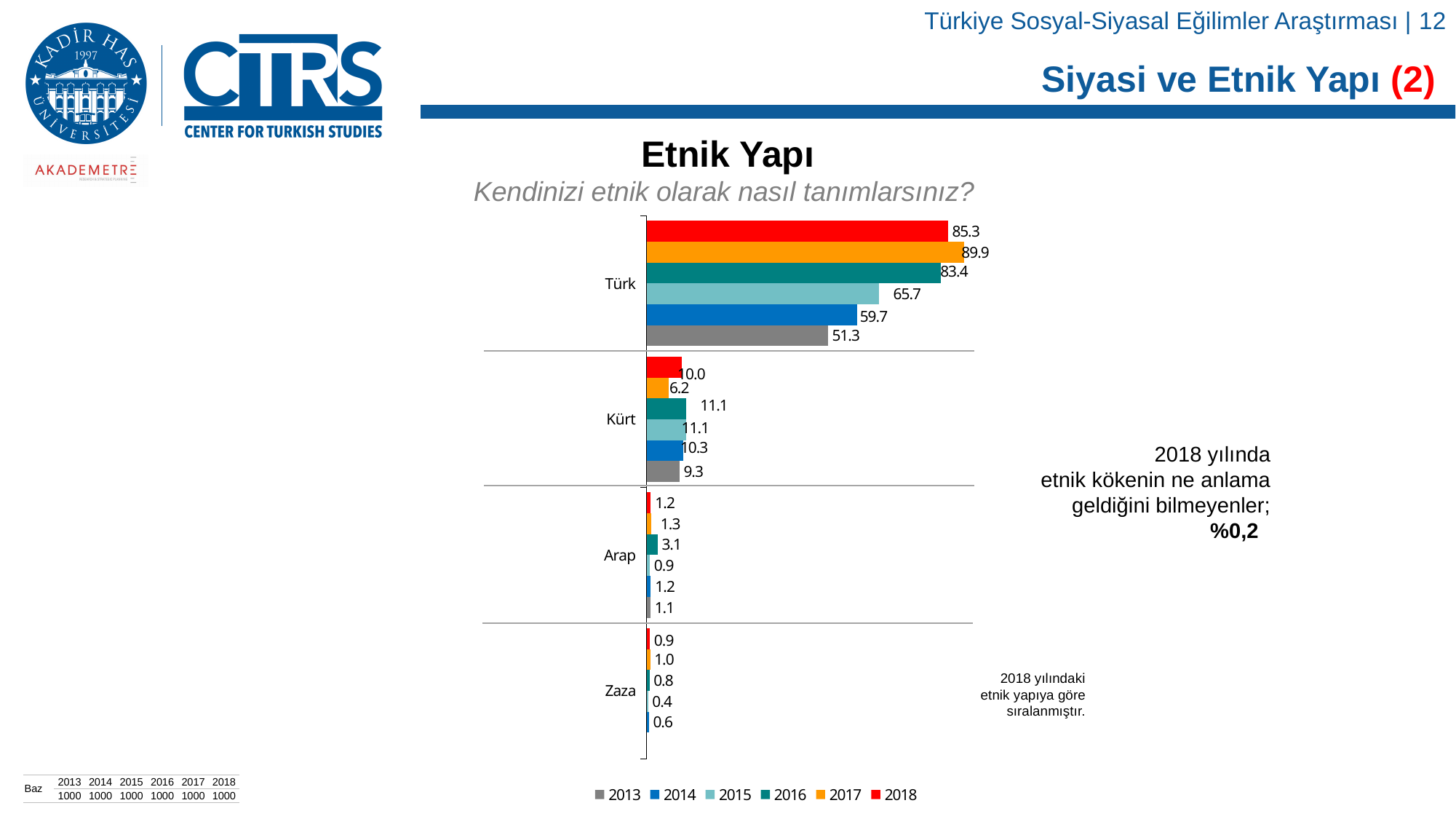
What is the value for Arap in 2016? 3.1 What is the difference between the Türk values for 2017 and 2013? 38.6 What is the value for Kürt in 2017? 6.2 What is the value for Zaza in 2015? 0.4 In which year was the value for Türk highest? 2017 How many ethnic categories are shown on the chart? 4 Which colour represents the 2018 series in the legend? red What kind of chart is shown on the slide? bar chart In which year was the value for Türk lowest? 2013 How many series does the legend list? 6 Which is larger for Kürt: the 2016 value or the 2017 value? 2016 What is the value for Türk in 2018? 85.3